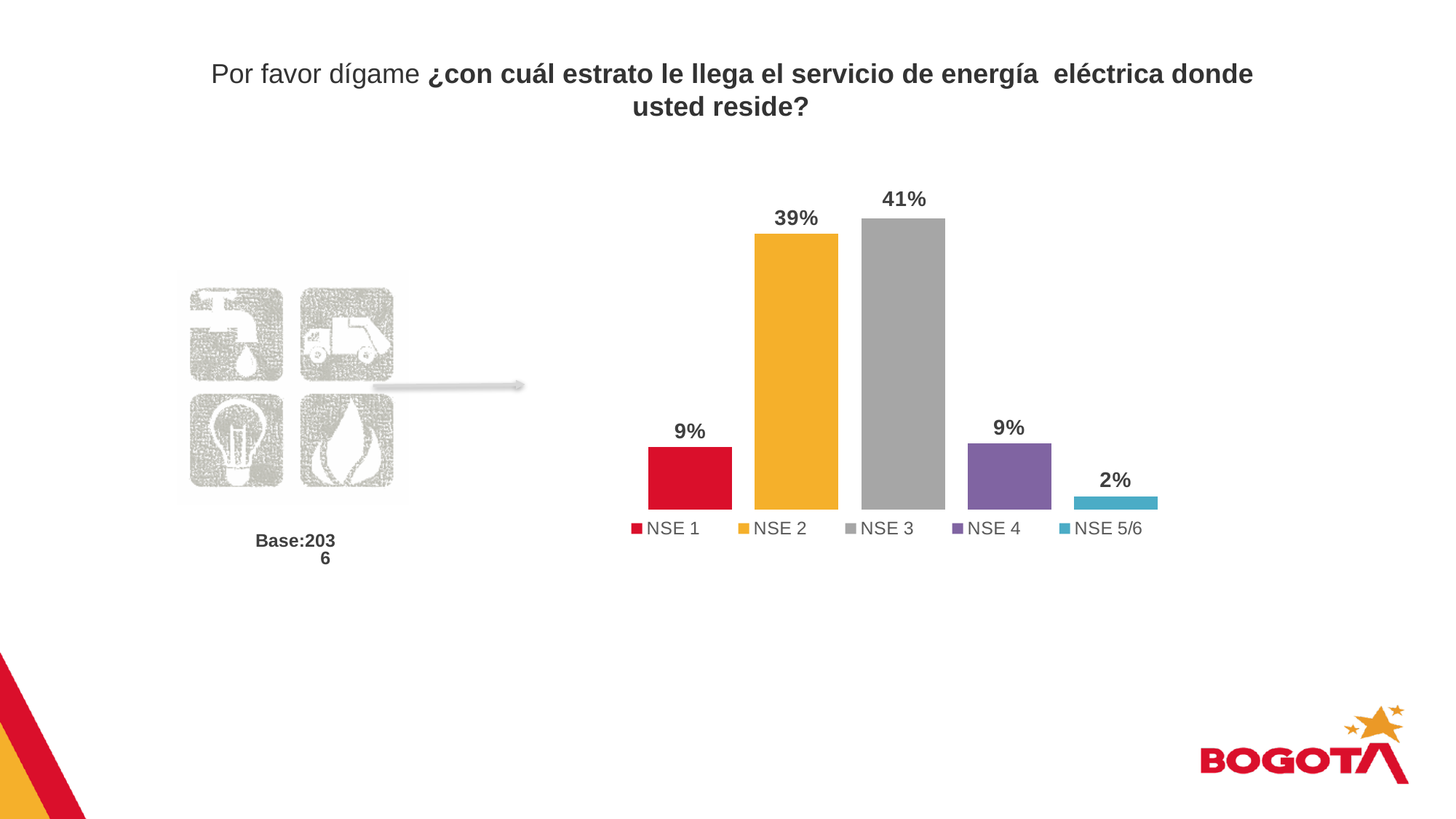
Which is larger, the value for NSE 4 or the value for NSE 5/6? NSE 4 What is the difference between the values for NSE 3 and NSE 2? 2% What kind of chart is shown on the slide? Bar chart What percentage is shown for NSE 5/6? 2% Which category has the lowest value? NSE 5/6 What percentage is shown for NSE 1? 9% Which category has the highest value? NSE 3 What percentage is shown for NSE 2? 39% What percentage is shown for NSE 3? 41% How many categories are shown in the chart? 5 What colour is the bar for NSE 2? Orange What is the difference between the values for NSE 2 and NSE 4? 30%